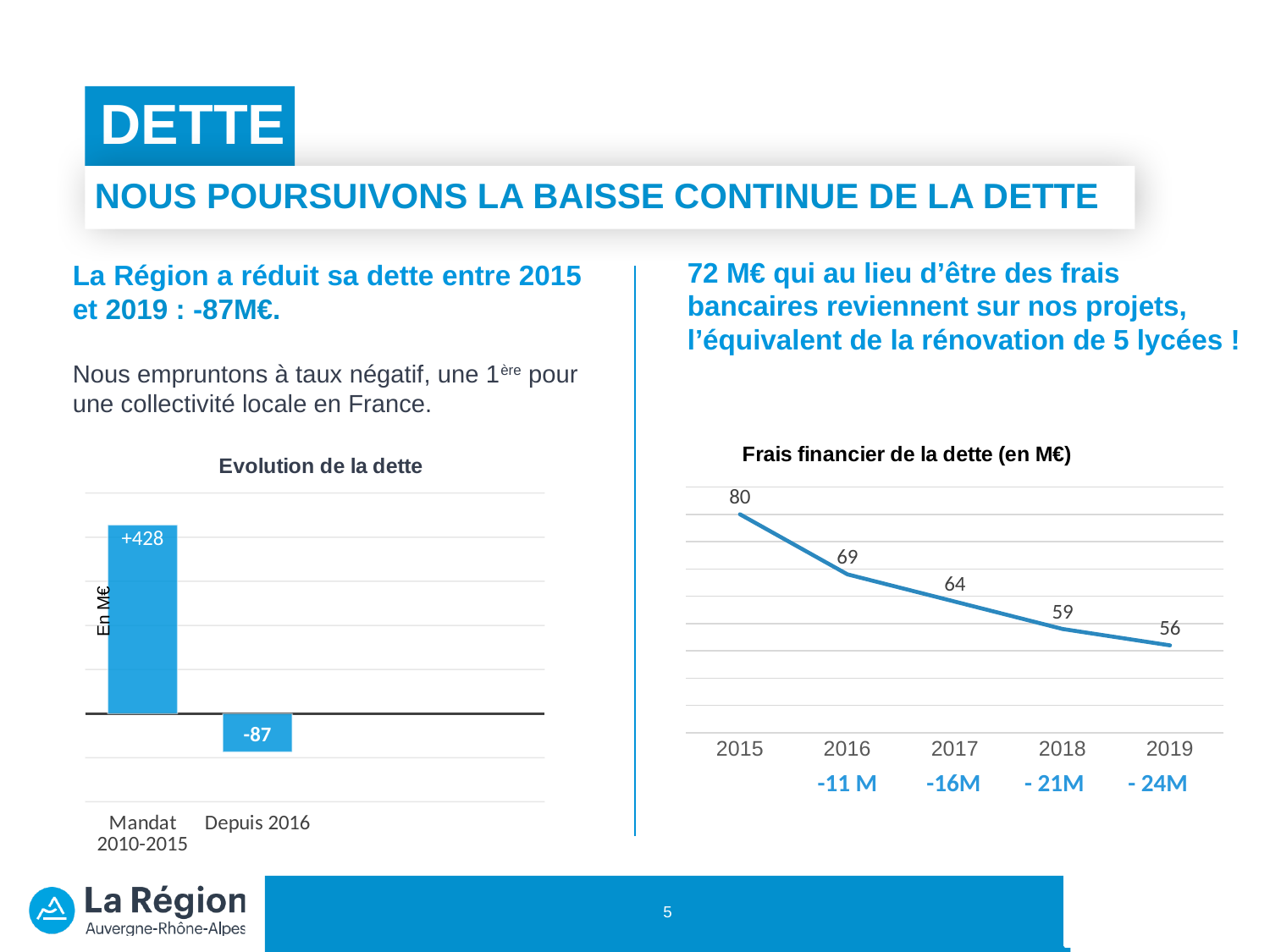
What kind of chart is 'Frais financier de la dette (en M€)'? Line chart In the 'Evolution de la dette' chart, what is the value for 'Depuis 2016'? -87 In the 'Frais financier de la dette (en M€)' chart, what is the value for 2019? 56 What kind of chart is 'Evolution de la dette'? Bar chart In the 'Frais financier de la dette (en M€)' chart, what is the difference between the 2015 and 2019 values? 24 In the 'Evolution de la dette' chart, what is the value for 'Mandat 2010-2015'? +428 In the 'Frais financier de la dette (en M€)' chart, which year has the lowest value? 2019 In the 'Frais financier de la dette (en M€)' chart, which year has the highest value? 2015 How many bars are plotted in the 'Evolution de la dette' chart? 2 In the 'Frais financier de la dette (en M€)' chart, do the values rise or fall from 2015 to 2019? Fall In the 'Frais financier de la dette (en M€)' chart, what is the value for 2015? 80 In the 'Frais financier de la dette (en M€)' chart, what is the value for 2017? 64